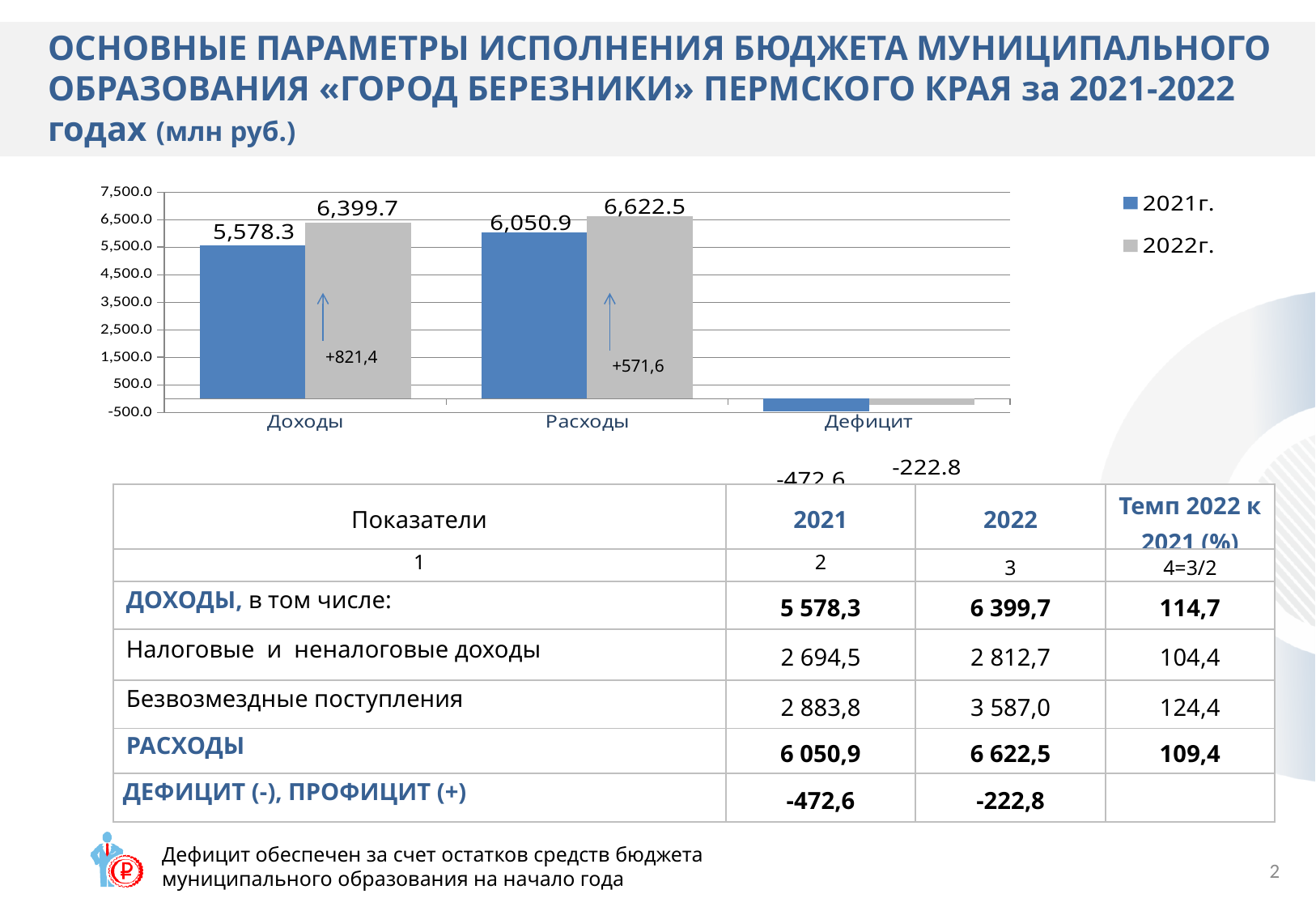
What is the value for Расходы in 2022г. on the chart? 6,622.5 How many categories are shown on the x axis of the chart? 3 What is the value for Расходы in 2021г. on the chart? 6,050.9 Which category has the lowest value for 2021г. on the chart? Дефицит How many series does the chart legend list? 2 What type of chart is shown on the slide? bar chart What is the value for Доходы in 2021г. on the chart? 5,578.3 By how much did Доходы increase from 2021г. to 2022г. according to the chart? +821,4 Which category has the highest value for 2022г. on the chart? Расходы What is the value for Дефицит in 2022г. on the chart? -222.8 Which is larger on the chart: Расходы in 2021г. or Доходы in 2022г.? Доходы in 2022г. What is the value for Доходы in 2022г. on the chart? 6,399.7